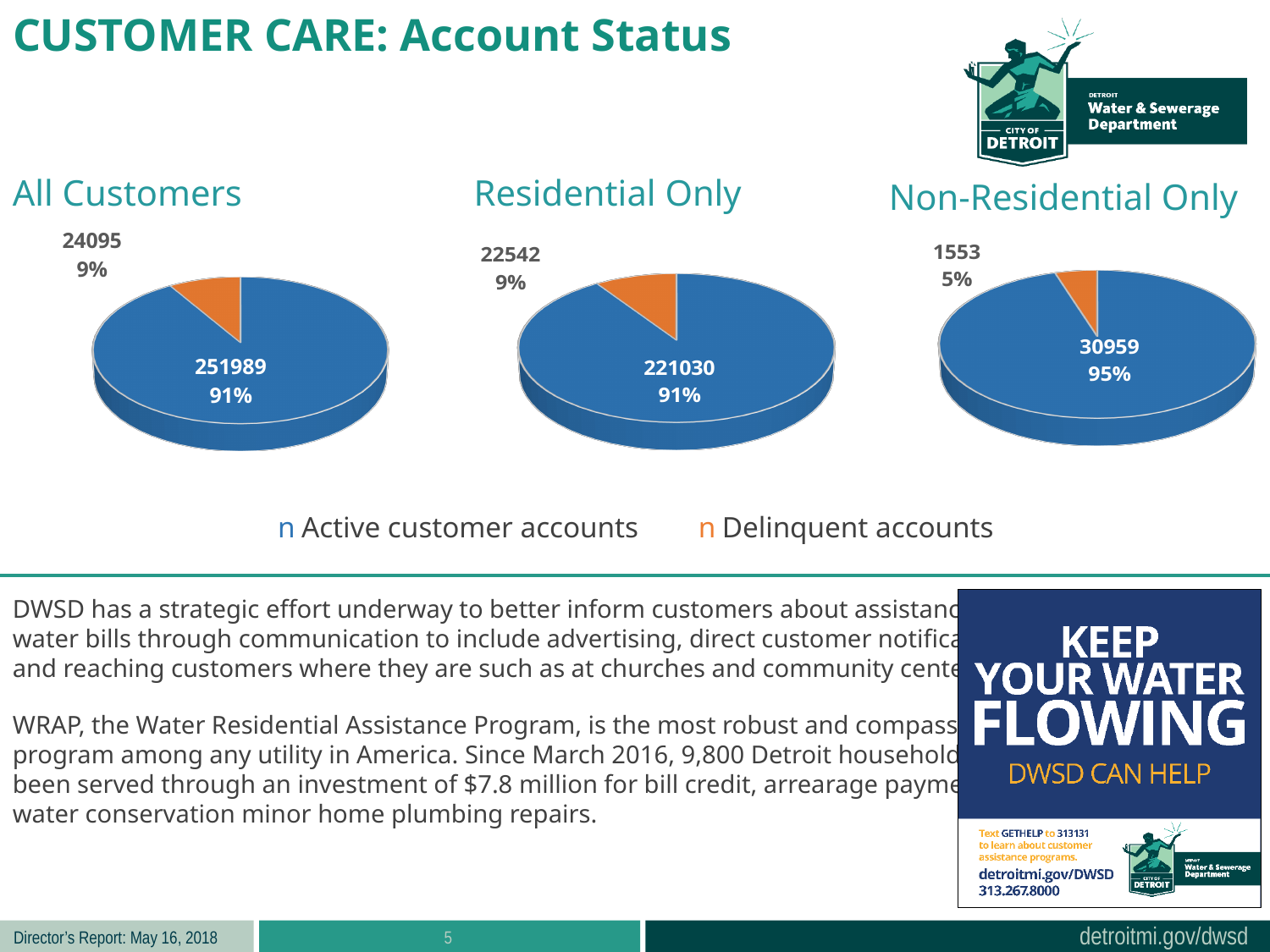
In the All Customers chart, what is the difference between the number of active customer accounts and delinquent accounts? 227894 In the Non-Residential Only chart, what share of accounts are delinquent? 5% In the All Customers chart, how many active customer accounts are there? 251989 In the Residential Only chart, how many delinquent accounts are there? 22542 In the Residential Only chart, what share of accounts are active customer accounts? 91% In the Residential Only chart, what is the total number of accounts shown across both slices? 243572 Which colour represents delinquent accounts in the charts? Orange How many series does the legend list for the charts? 2 What kind of chart is used for the All Customers data? Pie chart In the All Customers chart, what share of accounts are delinquent? 9% In the Non-Residential Only chart, how many active customer accounts are there? 30959 In the Non-Residential Only chart, which slice is larger, active customer accounts or delinquent accounts? Active customer accounts